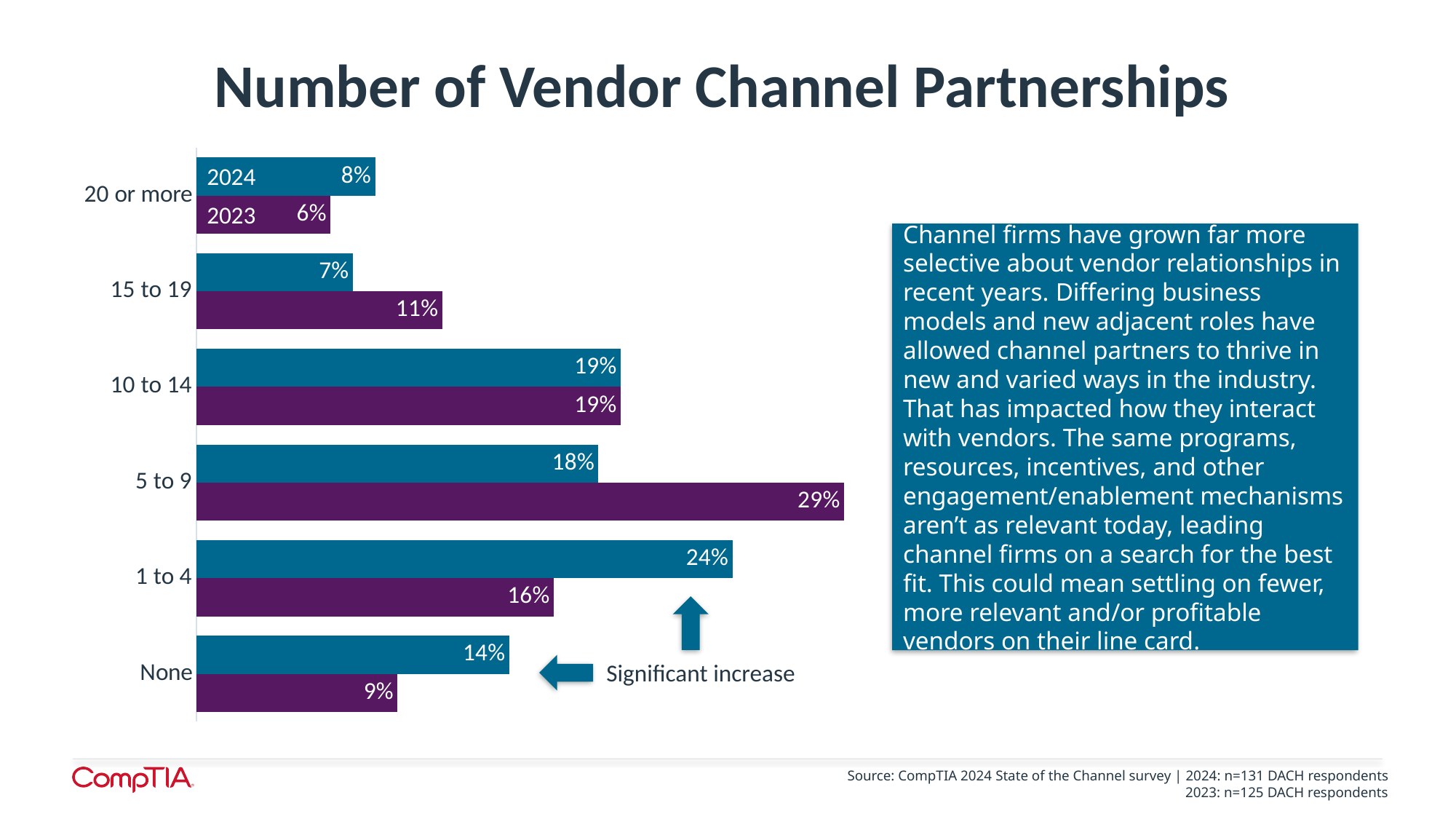
Which category has the highest 2023 value? 5 to 9 What is the 2023 value for '20 or more'? 6% How many categories are shown on the chart? 6 What is the difference between the 2023 and 2024 values for '5 to 9'? 11% What is the 2024 value for 'None'? 14% What type of chart is shown on the slide? Bar chart How many series does the chart show? 2 Which category has the lowest 2024 value? 15 to 19 What is the 2024 value for '1 to 4' vendor channel partnerships? 24% What is the difference between the 2024 and 2023 values for 'None'? 5% What is the 2023 value for '5 to 9' vendor channel partnerships? 29% For '15 to 19', which year has the larger value, 2024 or 2023? 2023